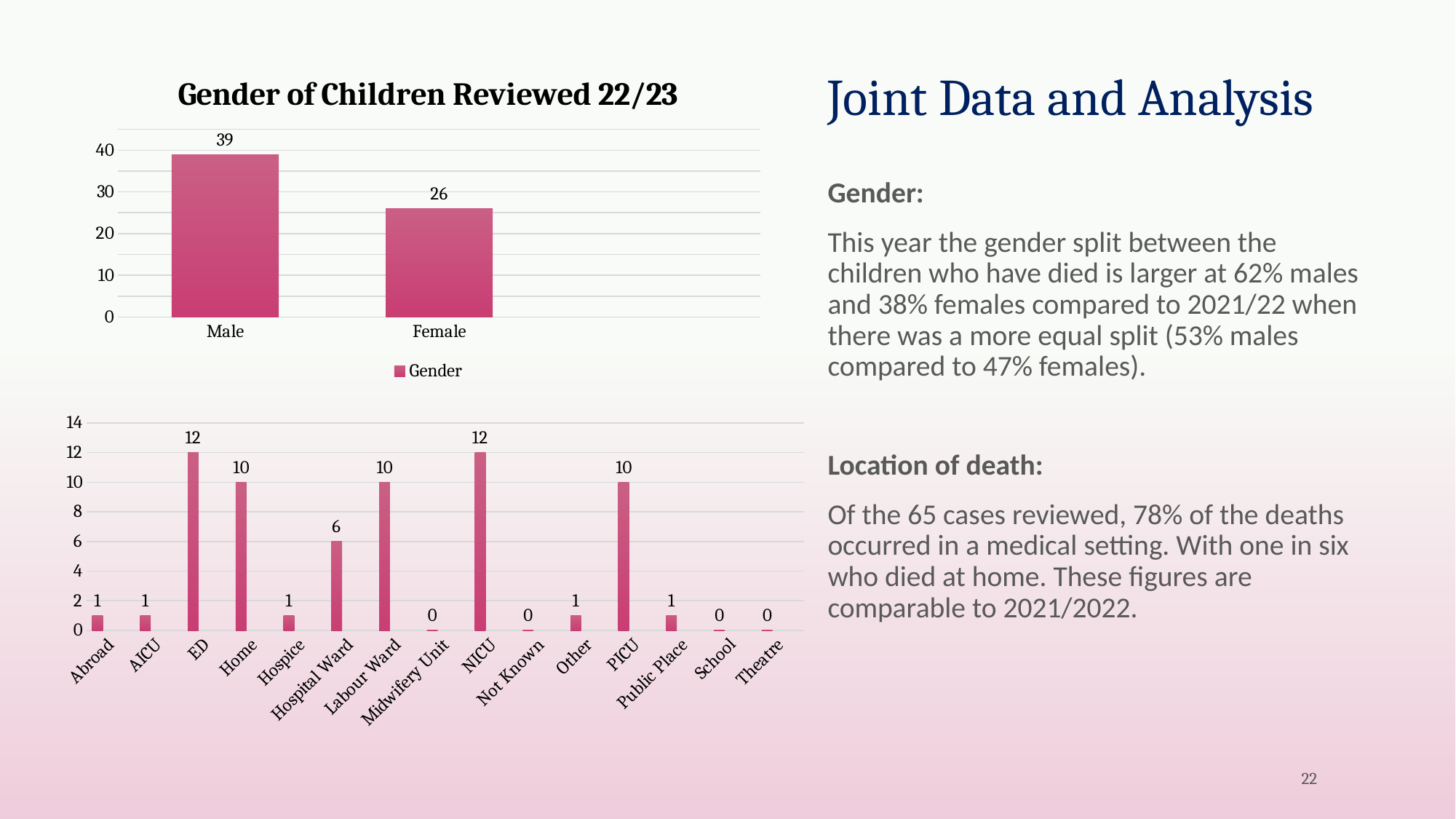
In the lower chart on the slide, what is the value for Midwifery Unit? 0 What kind of chart is the 'Gender of Children Reviewed 22/23' chart? Bar chart In the 'Gender of Children Reviewed 22/23' chart, what is the difference between the Male and Female values? 13 In the lower chart on the slide, which is larger, the value for Labour Ward or the value for Hospital Ward? Labour Ward In the lower chart on the slide, what is the value for Home? 10 In the lower chart on the slide, how many categories are shown on the x axis? 15 In the 'Gender of Children Reviewed 22/23' chart, how many series does the legend list? 1 In the lower chart on the slide, what is the difference between the values for NICU and PICU? 2 In the lower chart on the slide, which categories have the highest value? ED and NICU In the lower chart on the slide, what is the value for Hospital Ward? 6 In the 'Gender of Children Reviewed 22/23' chart, what is the value for Male? 39 In the 'Gender of Children Reviewed 22/23' chart, what is the value for Female? 26